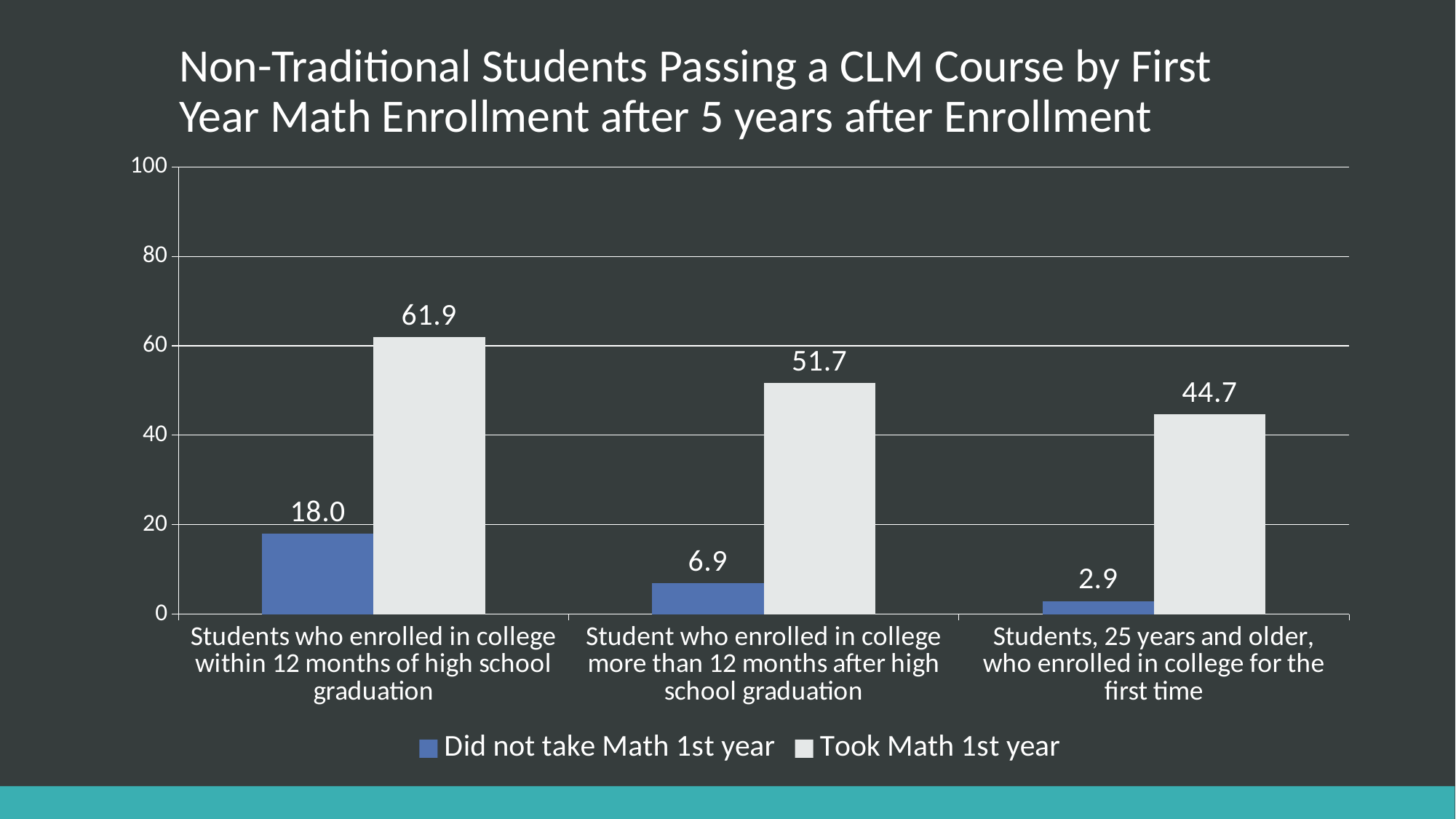
Is the 'Took Math 1st year' value for students, 25 years and older, greater or less than 40? greater Which is larger: 'Took Math 1st year' for students 25 years and older, or 'Took Math 1st year' for students who enrolled more than 12 months after high school graduation? Students who enrolled more than 12 months after high school graduation What is the value for 'Did not take Math 1st year' for students, 25 years and older, who enrolled in college for the first time? 2.9 Which category has the highest value for 'Took Math 1st year'? Students who enrolled in college within 12 months of high school graduation How many series does the legend list? 2 How many categories are shown on the x axis? 3 What is the value for 'Took Math 1st year' for students who enrolled in college within 12 months of high school graduation? 61.9 What is the difference between the 'Took Math 1st year' values for students who enrolled within 12 months and students who enrolled more than 12 months after high school graduation? 10.2 Which category has the lowest value for 'Did not take Math 1st year'? Students, 25 years and older, who enrolled in college for the first time What is the difference between 'Took Math 1st year' and 'Did not take Math 1st year' for students who enrolled in college within 12 months of high school graduation? 43.9 What is the value for 'Did not take Math 1st year' for students who enrolled in college more than 12 months after high school graduation? 6.9 What kind of chart is shown on the slide? Bar chart